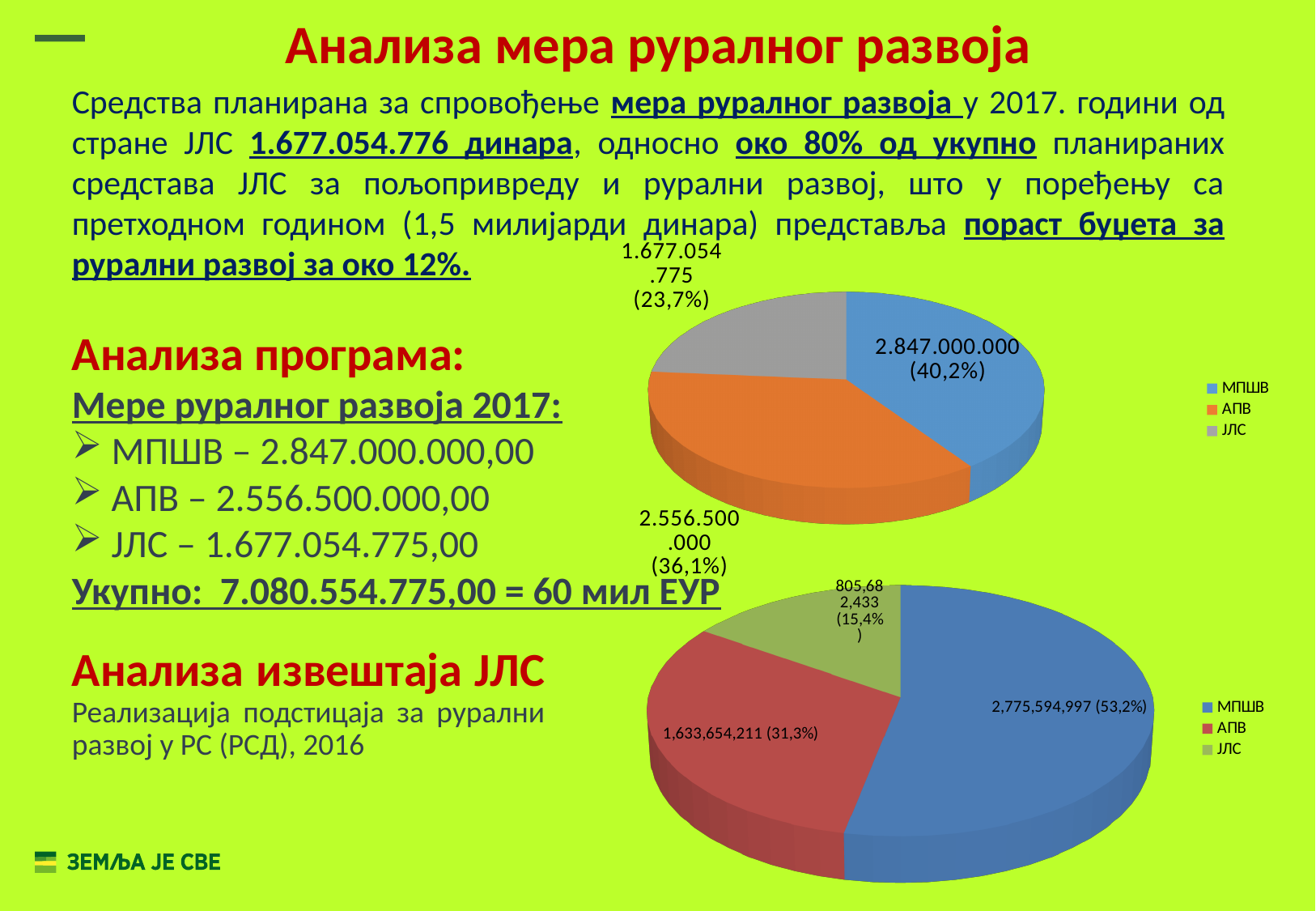
In the bottom pie chart, what share of the pie does ЈЛС have? 15,4% In the bottom pie chart, what value is shown for АПВ? 1,633,654,211 In the bottom pie chart, which category has the largest slice? МПШВ In the top pie chart, what share of the pie does АПВ have? 36,1% In the bottom pie chart, what value is shown for МПШВ? 2,775,594,997 In the top pie chart, what share of the pie does ЈЛС have? 23,7% How many slices does the bottom pie chart have? 3 How many series does the legend of the top pie chart list? 3 In the top pie chart, which category has the smallest slice? ЈЛС What type of chart is the top chart on the slide? pie chart In the bottom pie chart, which is larger, the slice for АПВ or the slice for ЈЛС? АПВ In the top pie chart, what value is shown for МПШВ? 2.847.000.000